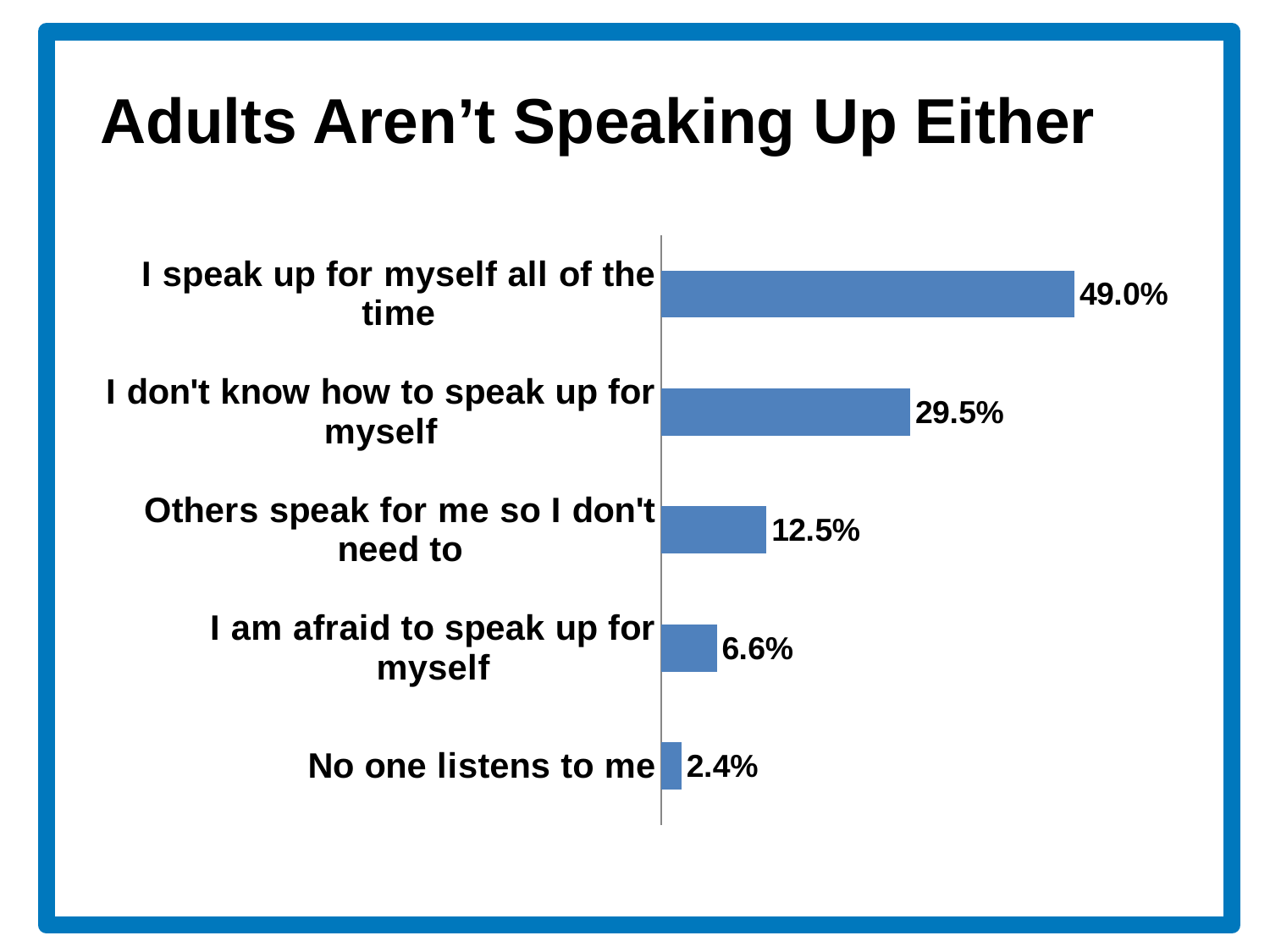
What is the title of the slide? Adults Aren't Speaking Up Either What percentage of respondents said "No one listens to me"? 2.4% What percentage is shown for "Others speak for me so I don't need to"? 12.5% Which is larger: "Others speak for me so I don't need to" or "I am afraid to speak up for myself"? Others speak for me so I don't need to Which category has the lowest value? No one listens to me What is the value for "I don't know how to speak up for myself"? 29.5% What is the difference between "I speak up for myself all of the time" and "I don't know how to speak up for myself"? 19.5% What is the value for "I am afraid to speak up for myself"? 6.6% Which category has the highest value? I speak up for myself all of the time How many categories are shown in the chart? 5 What percentage of respondents said "I speak up for myself all of the time"? 49.0% What kind of chart is shown on the slide? Bar chart